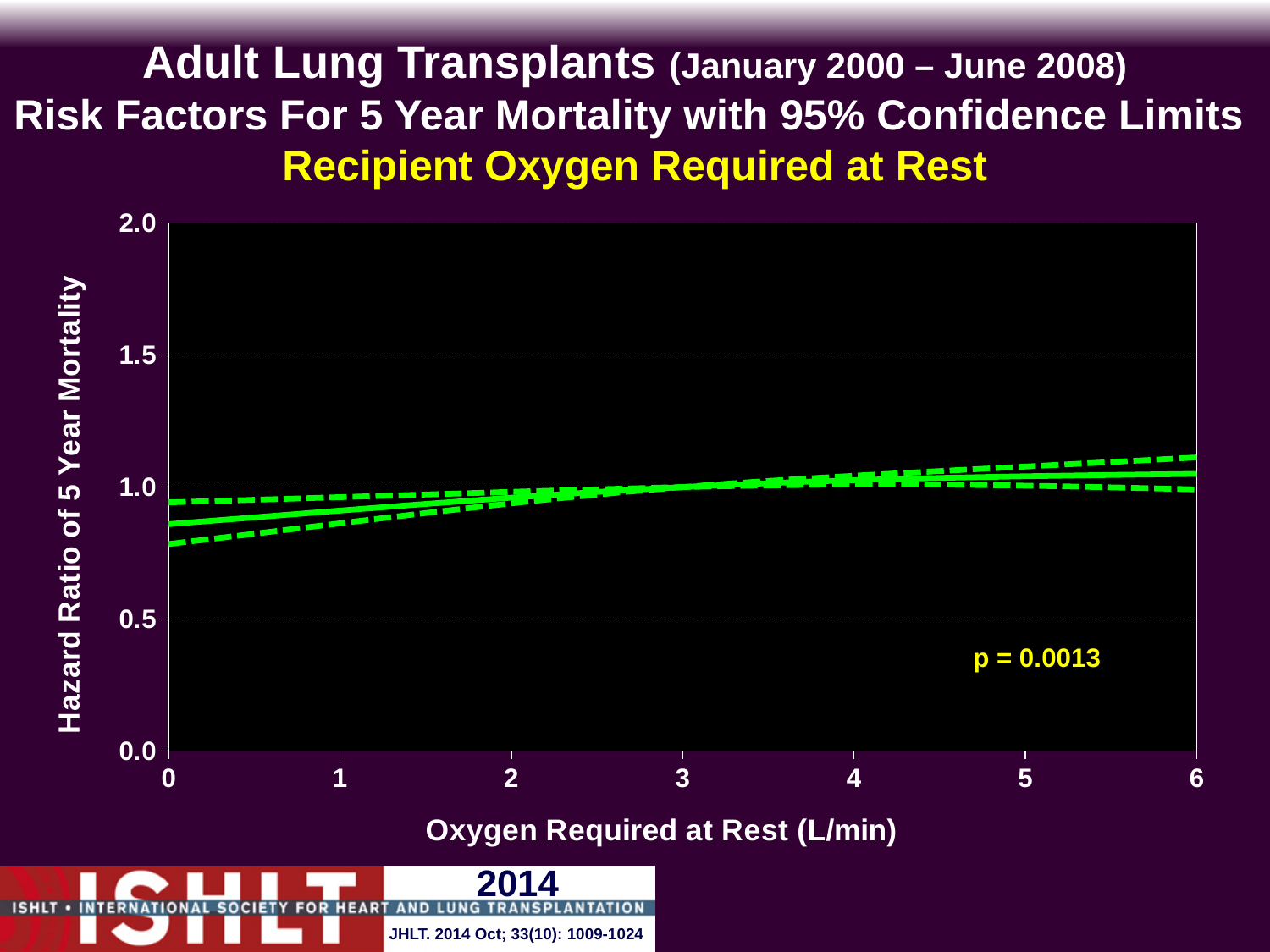
Does the hazard ratio rise or fall as oxygen required at rest increases from 0 to 6 L/min? rise Is the upper confidence limit at 6 L/min greater or less than 1.5? less What is the maximum value shown on the x axis? 6 Is the hazard ratio at 6 L/min oxygen required at rest greater or less than 1.0? greater Is the hazard ratio at 0 L/min oxygen required at rest greater or less than 1.0? less What is the maximum value shown on the y axis? 2.0 What is the label of the x axis? Oxygen Required at Rest (L/min) What kind of chart is shown on the slide? line chart What is the p-value shown on the chart? p = 0.0013 How many lines are plotted on the chart? 3